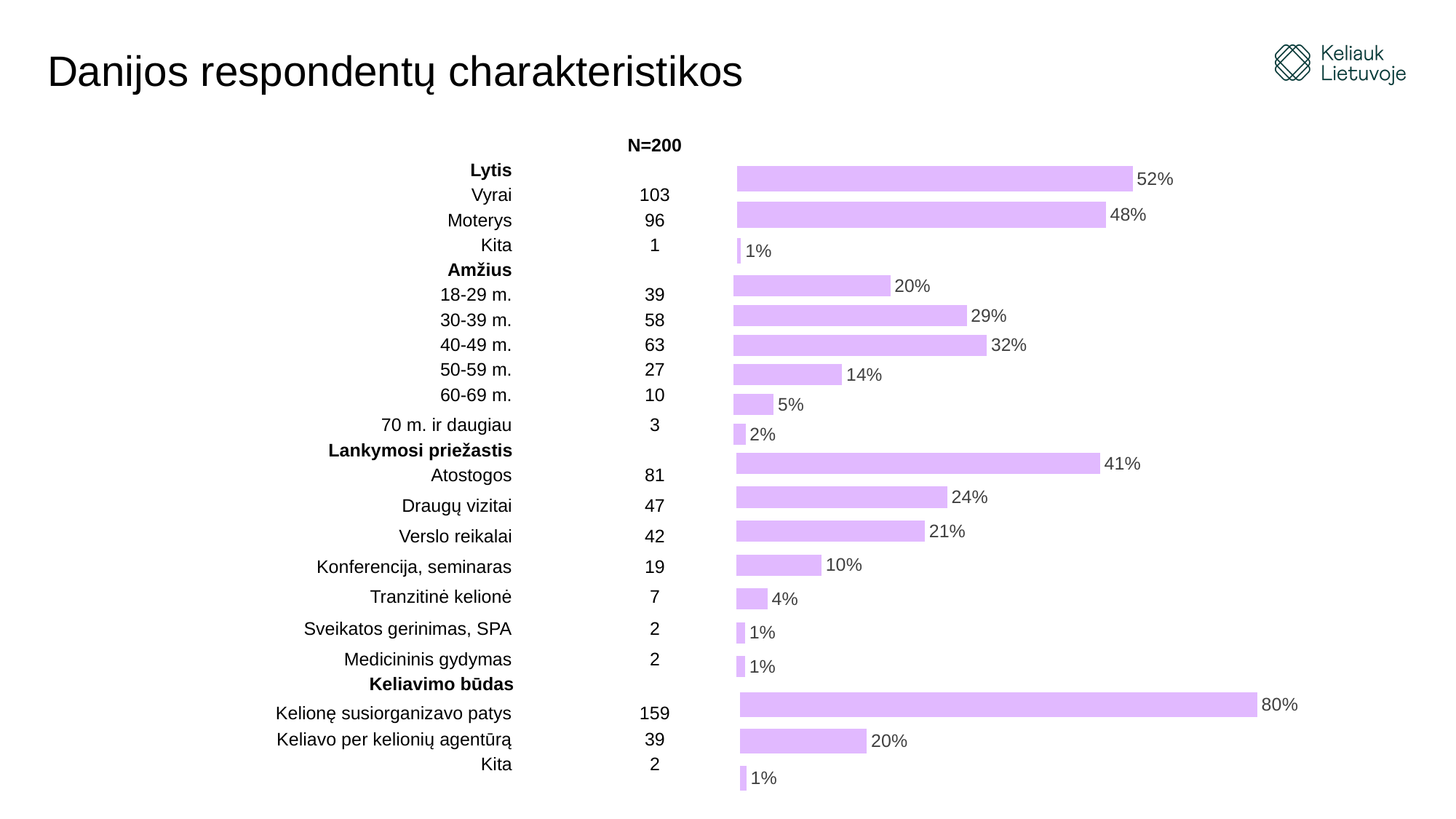
Which is larger, the percentage for Draugų vizitai or for Verslo reikalai? Draugų vizitai What percentage is shown for Kelionę susiorganizavo patys under Keliavimo būdas? 80% What is the difference in percentage points between Vyrai and Moterys? 4 What percentage is shown for Atostogos under Lankymosi priežastis? 41% What percentage is shown for Vyrai in the Lytis section? 52% Which age group in the Amžius section has the highest percentage? 40-49 m. What percentage is shown for the 40-49 m. age group? 32% Which category in the Lankymosi priežastis section has the lowest count? Sveikatos gerinimas, SPA and Medicininis gydymas (2 each) How many age groups are listed in the Amžius section? 6 What is the total number of respondents (N) stated on the slide? 200 What kind of chart is used to show the percentages on the slide? Bar chart What is the difference in percentage points between Kelionę susiorganizavo patys and Keliavo per kelionių agentūrą? 60